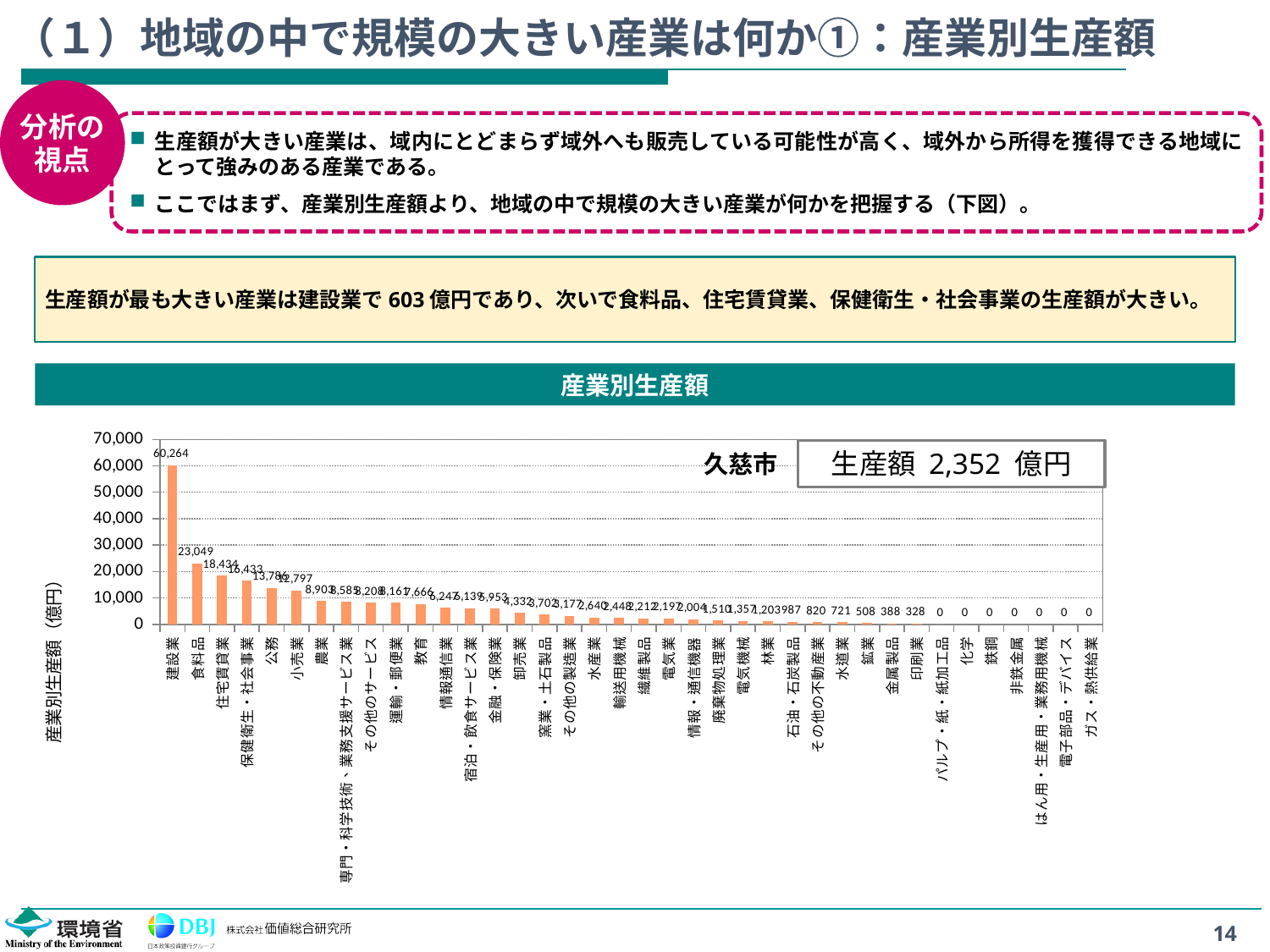
What is the value for 建設業 in the 産業別生産額 chart? 60,264 What is the value for 食料品 in the 産業別生産額 chart? 23,049 Do the values in the 産業別生産額 chart rise or fall from left to right along the x axis? fall What kind of chart is the 産業別生産額 chart? bar chart What is the value for 水道業 in the 産業別生産額 chart? 721 What total 生産額 is shown for 久慈市 in the box on the 産業別生産額 chart? 2,352 億円 What is the difference between the values for 建設業 and 食料品 in the 産業別生産額 chart? 37,215 What is the value for 鉱業 in the 産業別生産額 chart? 508 Which industry has the highest value in the 産業別生産額 chart? 建設業 What is the value for 農業 in the 産業別生産額 chart? 8,903 Which has a larger value in the 産業別生産額 chart, 卸売業 or 林業? 卸売業 Is the value for 公務 in the 産業別生産額 chart greater or less than 10,000? greater